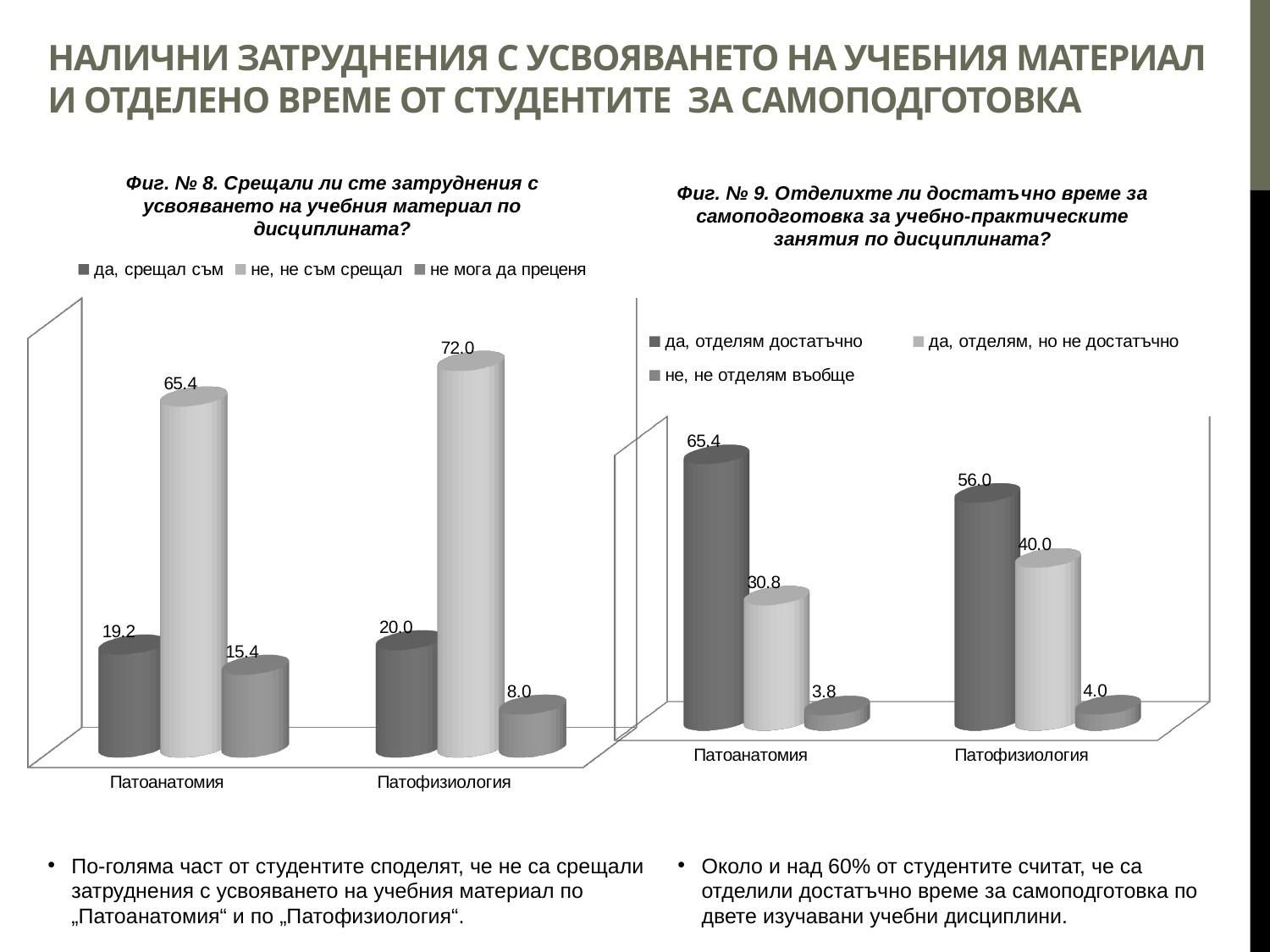
In the chart 'Фиг. № 9', is 'да, отделям достатъчно' larger for Патоанатомия or for Патофизиология? Патоанатомия In the chart 'Фиг. № 8', which series has the lowest value for Патофизиология? не мога да преценя In the chart 'Фиг. № 9', which series has the highest value for Патоанатомия? да, отделям достатъчно In the chart 'Фиг. № 8', what is the difference between 'не, не съм срещал' for Патофизиология and for Патоанатомия? 6.6 In the chart 'Фиг. № 8', what is the value for 'да, срещал съм' for Патоанатомия? 19.2 In the chart 'Фиг. № 9', how many categories are shown on the x axis? 2 In the chart 'Фиг. № 8', how many series does the legend list? 3 In the chart 'Фиг. № 9', what is the value for 'не, не отделям въобще' for Патоанатомия? 3.8 In the chart 'Фиг. № 8', what is the value for 'не, не съм срещал' for Патофизиология? 72.0 In the chart 'Фиг. № 9', what is the value for 'да, отделям, но не достатъчно' for Патофизиология? 40.0 What kind of chart is 'Фиг. № 8'? bar chart In the chart 'Фиг. № 9', what is the difference between 'да, отделям достатъчно' and 'да, отделям, но не достатъчно' for Патофизиология? 16.0